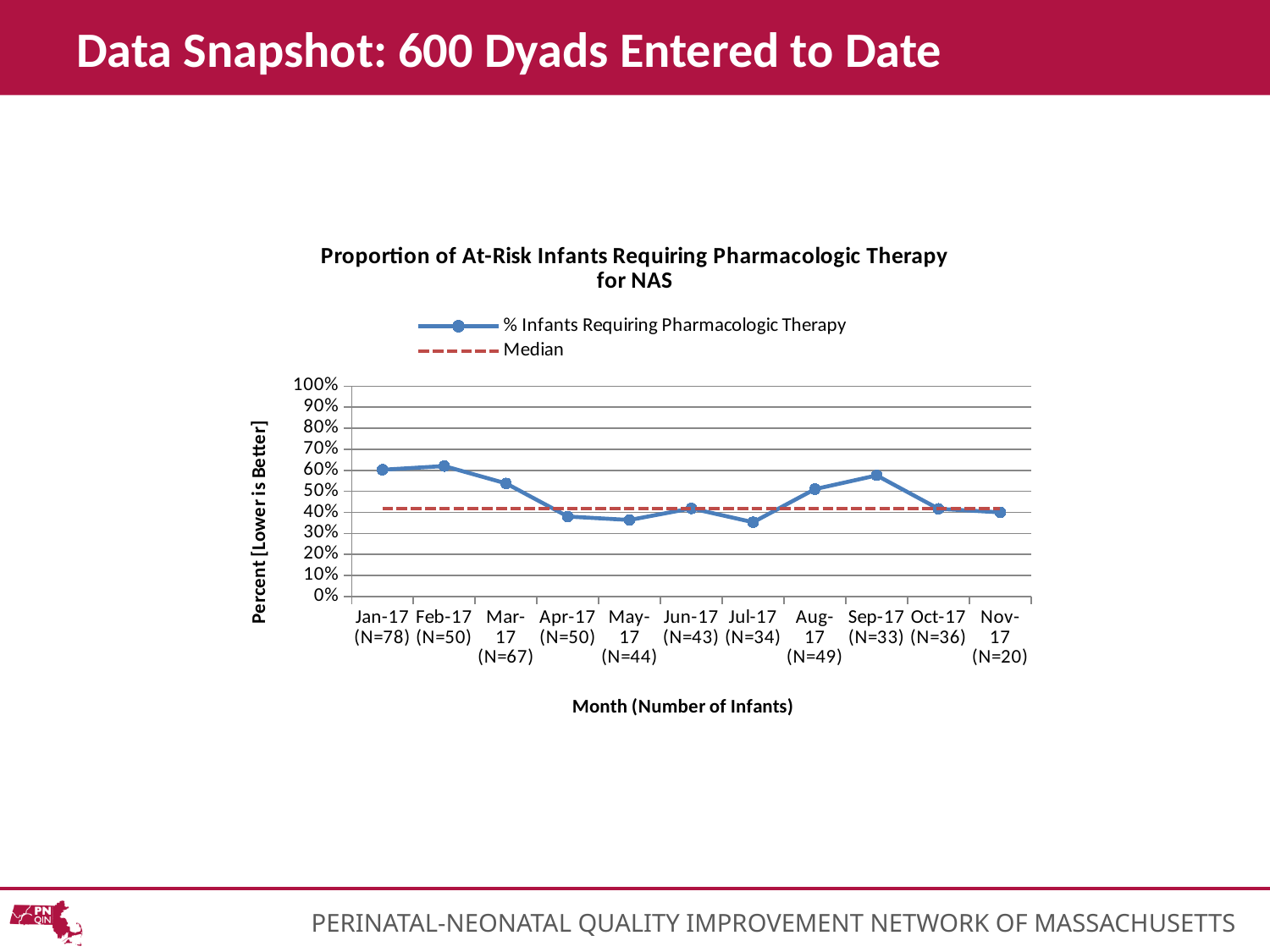
Is the value for Jan-17 greater or less than 50%? greater How many months are plotted along the x axis? 11 What is the title of the y axis? Percent [Lower is Better] Is the value for Mar-17 greater or less than 50%? greater Which is larger, the value for Feb-17 or the value for May-17? Feb-17 Which month has the highest percentage of infants requiring pharmacologic therapy? Feb-17 Do the values rise or fall from Jan-17 to Apr-17? fall Is the value for Jul-17 greater or less than 40%? less How many series does the legend list? 2 What kind of chart is shown on the slide? line chart